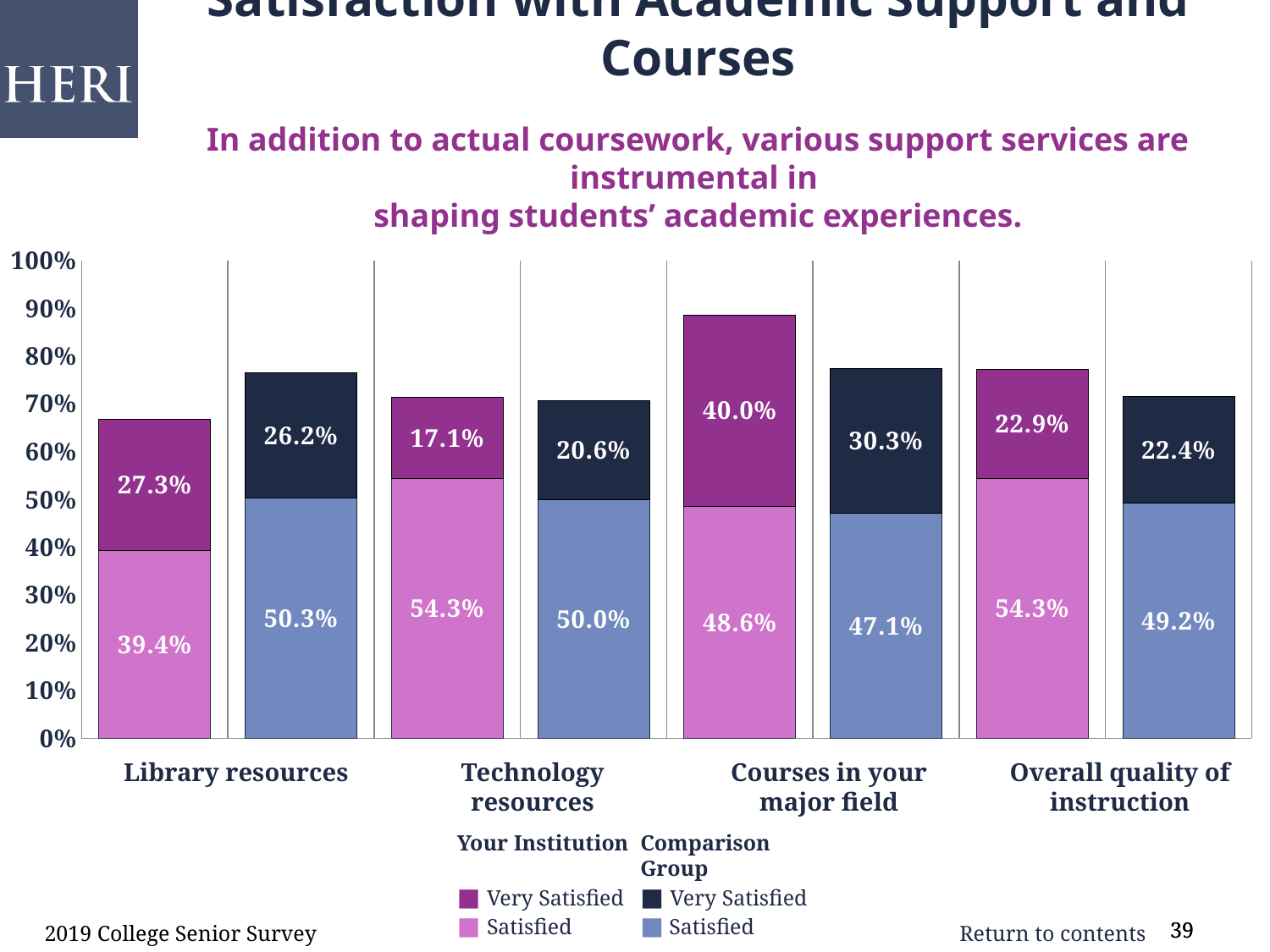
What percentage of the Comparison Group is Satisfied with Library resources? 50.3% What percentage of Your Institution students are Satisfied with Technology resources? 54.3% Across the four categories, which has the highest Very Satisfied percentage for Your Institution? Courses in your major field What is the difference between the Very Satisfied percentages for Your Institution and the Comparison Group for Courses in your major field? 9.7 percentage points For Library resources, which is larger: the Satisfied percentage for Your Institution or for the Comparison Group? Comparison Group Which category has the lowest Satisfied percentage for Your Institution? Library resources What percentage of Your Institution students are Very Satisfied with Courses in your major field? 40.0% What is the total (Satisfied plus Very Satisfied) for Your Institution for Courses in your major field? 88.6% What percentage of the Comparison Group is Very Satisfied with Overall quality of instruction? 22.4% How many categories are shown on the x axis of the chart? 4 How many series does the chart legend list? 4 What is the total (Satisfied plus Very Satisfied) for the Comparison Group for Library resources? 76.5%